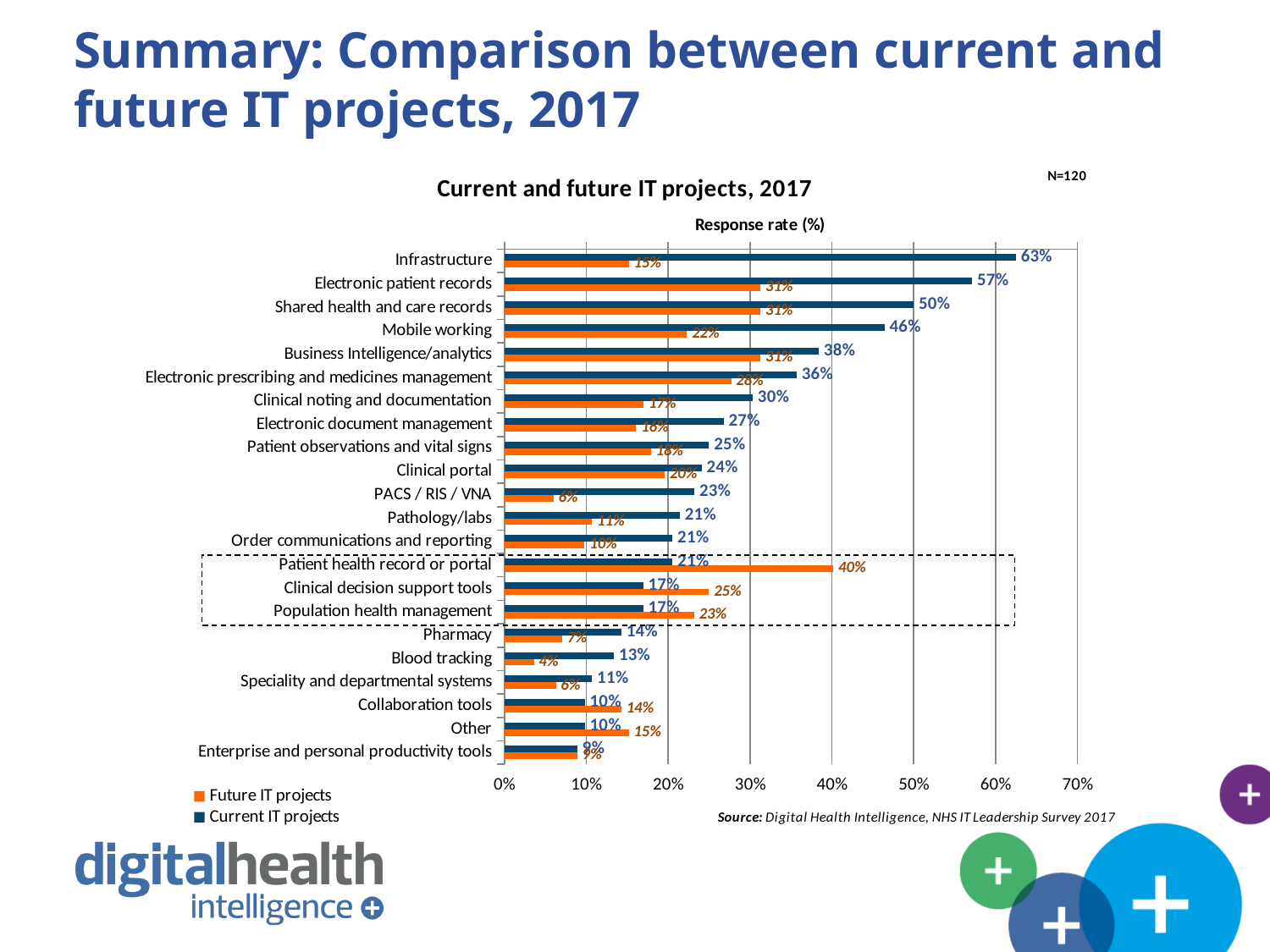
What is the value for Current IT projects for Mobile working? 46% Which category has the highest value for Current IT projects? Infrastructure What is the value for Future IT projects for PACS / RIS / VNA? 6% Which colour represents Future IT projects in the chart? Orange What is the value for Current IT projects for Infrastructure? 63% What is the value for Future IT projects for Patient health record or portal? 40% What is the difference between the Current IT projects value and the Future IT projects value for Infrastructure? 48% How many categories are shown on the chart? 22 For Clinical decision support tools, which is larger: the Current IT projects value or the Future IT projects value? Future IT projects Which category has the highest value for Future IT projects? Patient health record or portal What kind of chart is shown on the slide? Bar chart How many series does the legend list? 2